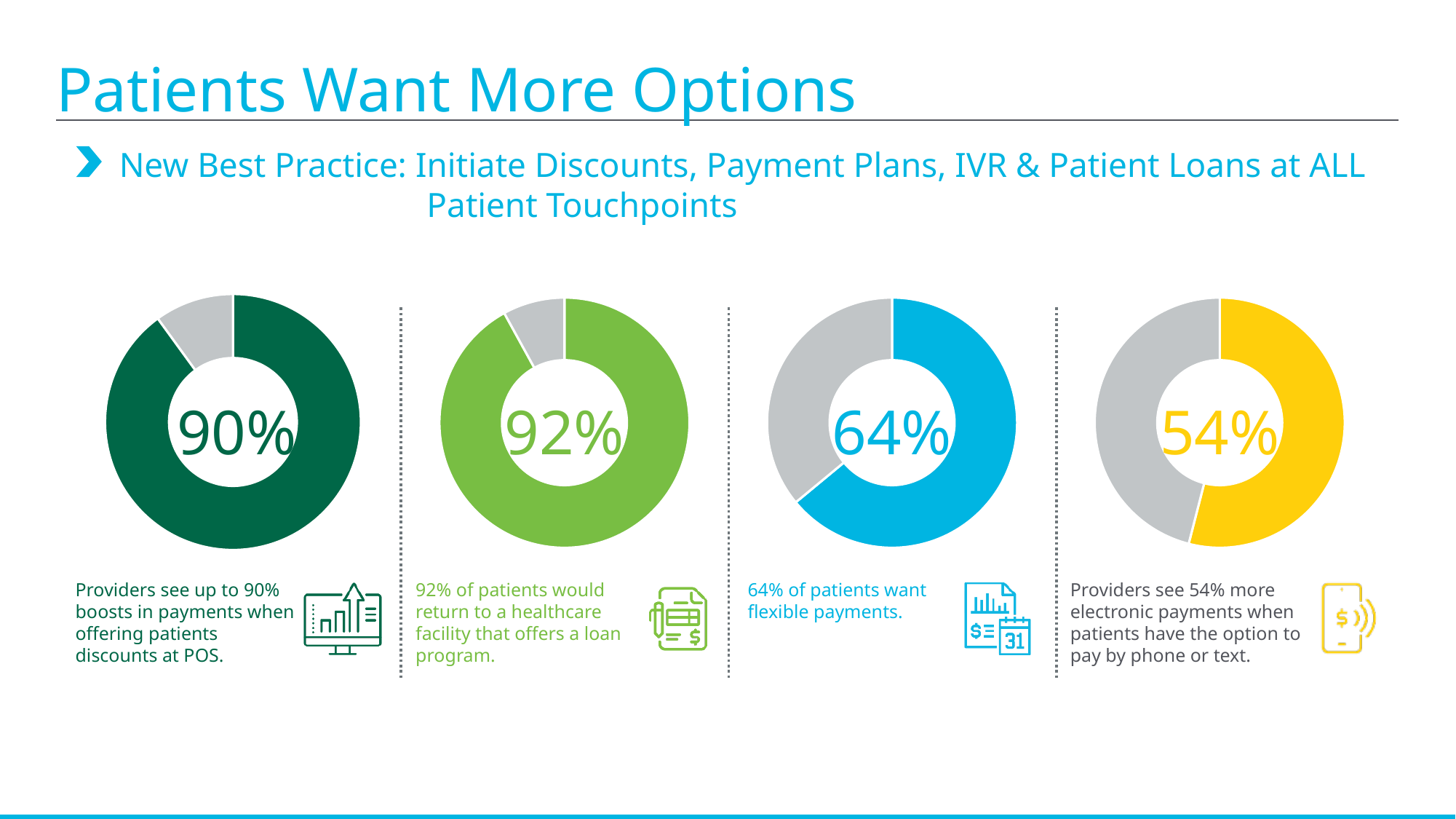
Which of the four donut charts shows the lowest percentage? The rightmost (54%) What percentage is shown in the second donut chart from the left, about patients who would return to a facility that offers a loan program? 92% Which of the four donut charts shows the highest percentage? The second from the left (92%) What percentage of patients want flexible payments, according to the third donut chart? 64% Which is larger: the percentage in the leftmost donut chart or the percentage in the second donut chart from the left? The second from the left (92%) How many donut charts are shown on the slide? 4 What kind of chart is used to display the four statistics on the slide? Donut chart What percentage is shown in the rightmost donut chart, about more electronic payments when patients can pay by phone or text? 54% What colour is the filled portion of the third donut chart (64%)? Blue What is the difference between the percentage in the third donut chart (64%) and the rightmost donut chart (54%)? 10% What colour is the filled portion of the rightmost donut chart (54%)? Yellow What percentage is shown in the centre of the leftmost donut chart (providers' boost in payments when offering discounts at POS)? 90%